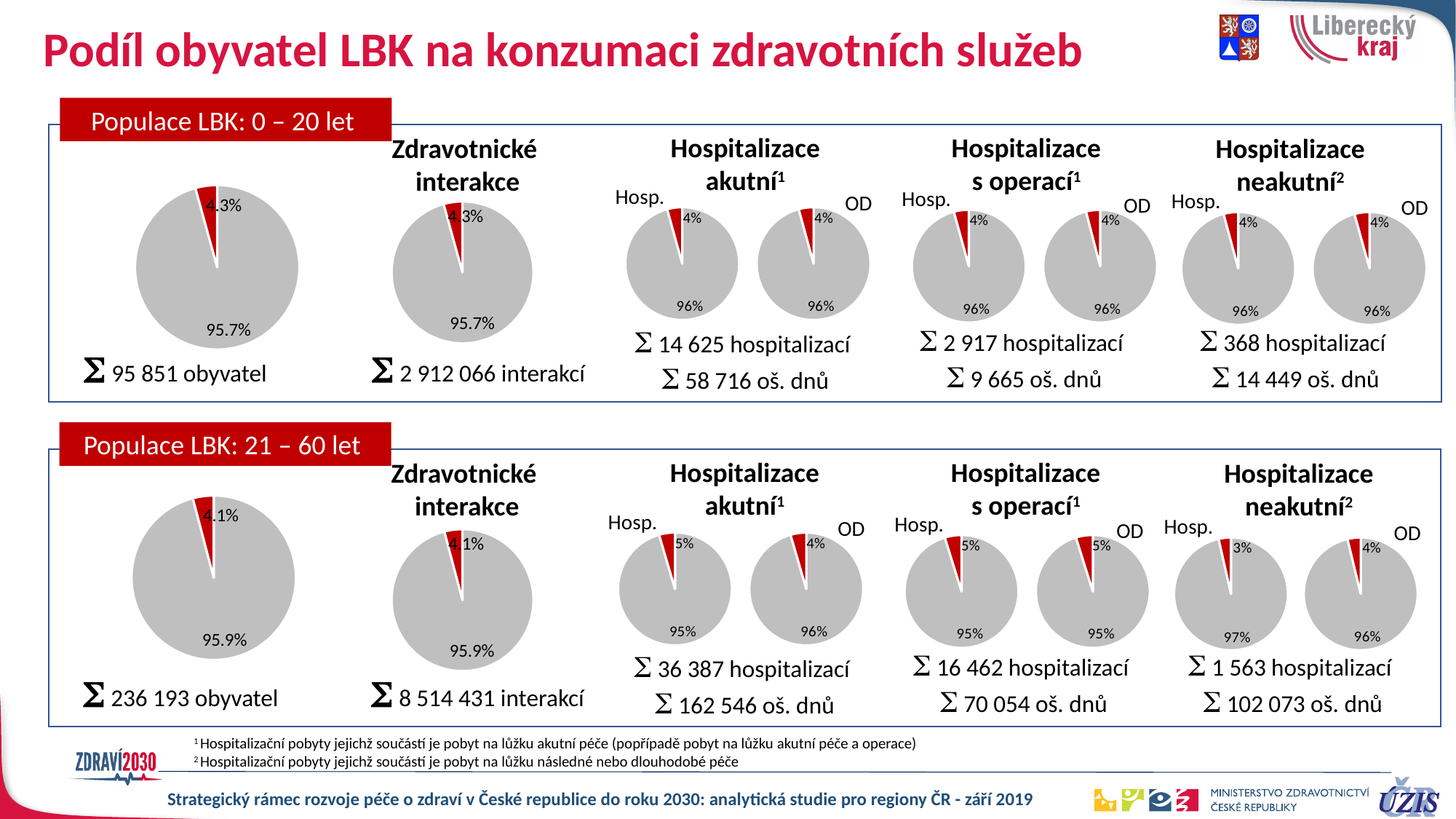
What type of chart is used throughout the slide? Pie chart In the 'Populace LBK: 0 – 20 let' panel, what share does the red slice of the first (population) pie chart show? 4.3% How many slices does the first (population) pie chart in the 'Populace LBK: 0 – 20 let' panel have? 2 In the 'Populace LBK: 21 – 60 let' panel, what share does the grey slice of the 'Hosp.' pie under 'Hospitalizace neakutní' show? 97% In the 'Populace LBK: 21 – 60 let' panel, what share does the red slice of the 'Hosp.' pie under 'Hospitalizace akutní' show? 5% In the 'Populace LBK: 21 – 60 let' panel, which slice is larger in the 'Hosp.' pie under 'Hospitalizace akutní': the red slice or the grey slice? The grey slice In the 'Populace LBK: 21 – 60 let' panel, what share does the red slice of the first (population) pie chart show? 4.1% In the 'Populace LBK: 0 – 20 let' panel, what share does the red slice of the 'OD' pie under 'Hospitalizace s operací' show? 4% In the 'Populace LBK: 21 – 60 let' panel, what share does the red slice of the 'Hosp.' pie under 'Hospitalizace neakutní' show? 3% In the 'Populace LBK: 21 – 60 let' panel, what share does the grey slice of the 'Zdravotnické interakce' pie chart show? 95.9% In the 'Populace LBK: 0 – 20 let' panel, what share does the grey slice of the 'Zdravotnické interakce' pie chart show? 95.7% In the 'Populace LBK: 21 – 60 let' panel, which is larger: the red slice of the 'Hosp.' pie under 'Hospitalizace akutní' (5%) or the red slice of the 'Hosp.' pie under 'Hospitalizace neakutní' (3%)? Hospitalizace akutní (5%)